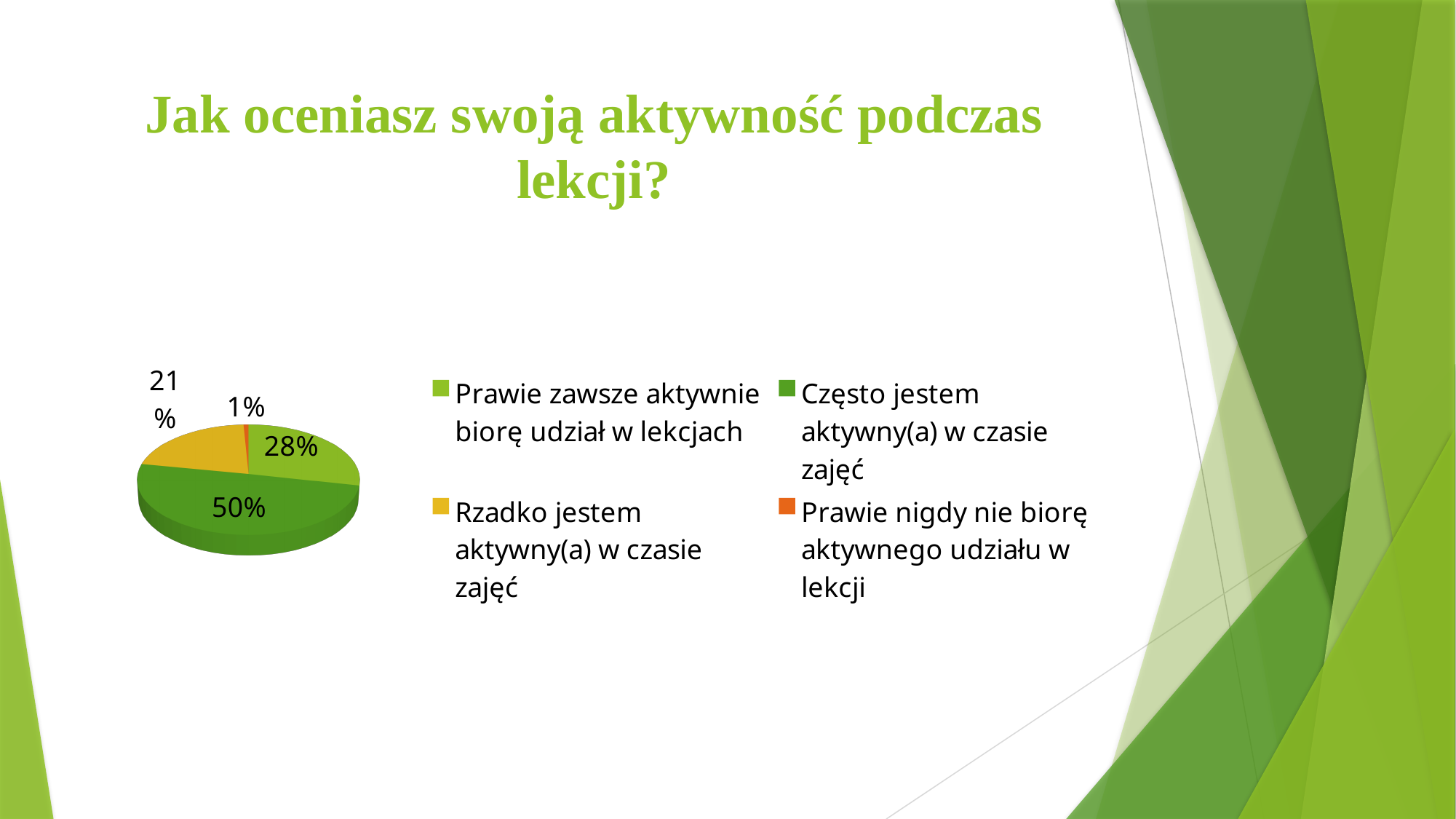
Which is larger: the share for "Prawie zawsze aktywnie biorę udział w lekcjach" or the share for "Rzadko jestem aktywny(a) w czasie zajęć"? Prawie zawsze aktywnie biorę udział w lekcjach What colour is the slice for "Rzadko jestem aktywny(a) w czasie zajęć"? Yellow What share of the pie is labelled "Prawie nigdy nie biorę aktywnego udziału w lekcji"? 1% What kind of chart is shown on the slide? Pie chart What share of the pie is labelled "Prawie zawsze aktywnie biorę udział w lekcjach"? 28% What is the difference between the share for "Często jestem aktywny(a) w czasie zajęć" and the share for "Prawie zawsze aktywnie biorę udział w lekcjach"? 22% Which category has the largest slice of the pie? Często jestem aktywny(a) w czasie zajęć Which category has the smallest slice of the pie? Prawie nigdy nie biorę aktywnego udziału w lekcji What share of the pie is labelled "Często jestem aktywny(a) w czasie zajęć"? 50% How many slices does the pie chart have? 4 What is the title of the slide containing the pie chart? Jak oceniasz swoją aktywność podczas lekcji?